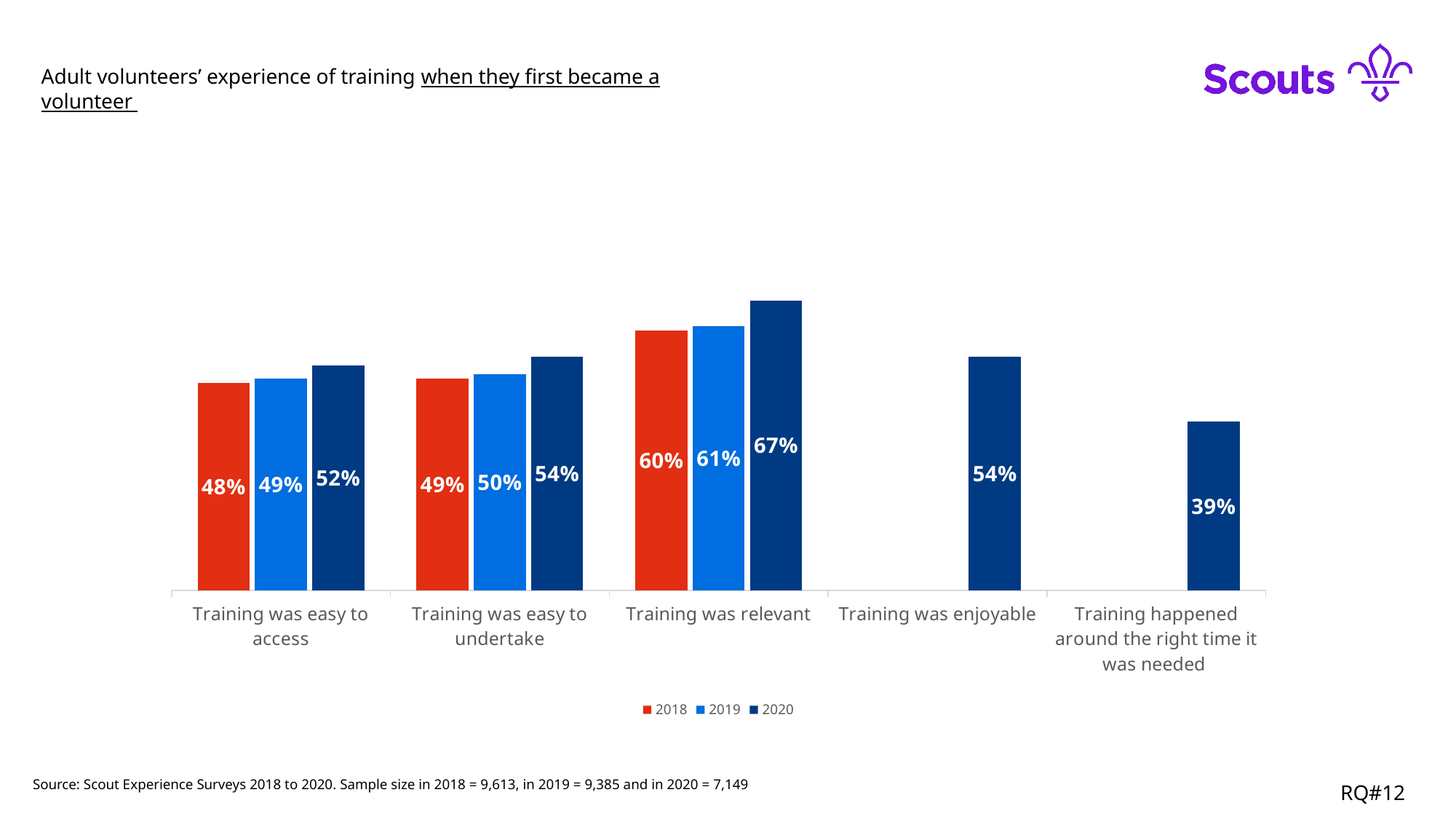
Do the values for 'Training was easy to undertake' rise or fall from 2018 to 2020? Rise What was the 2019 value for 'Training was easy to undertake'? 50% Which is larger: the 2020 value for 'Training was enjoyable' or the 2020 value for 'Training was easy to access'? Training was enjoyable Which category has the lowest 2020 value? Training happened around the right time it was needed What kind of chart is shown on the slide? Bar chart Which category has the highest 2020 value? Training was relevant How many categories are shown on the x axis? 5 What was the 2018 value for 'Training was easy to access'? 48% What was the 2020 value for 'Training happened around the right time it was needed'? 39% What is the difference between the 2020 and 2018 values for 'Training was relevant'? 7% What was the 2020 value for 'Training was relevant'? 67% How many series does the legend list? 3